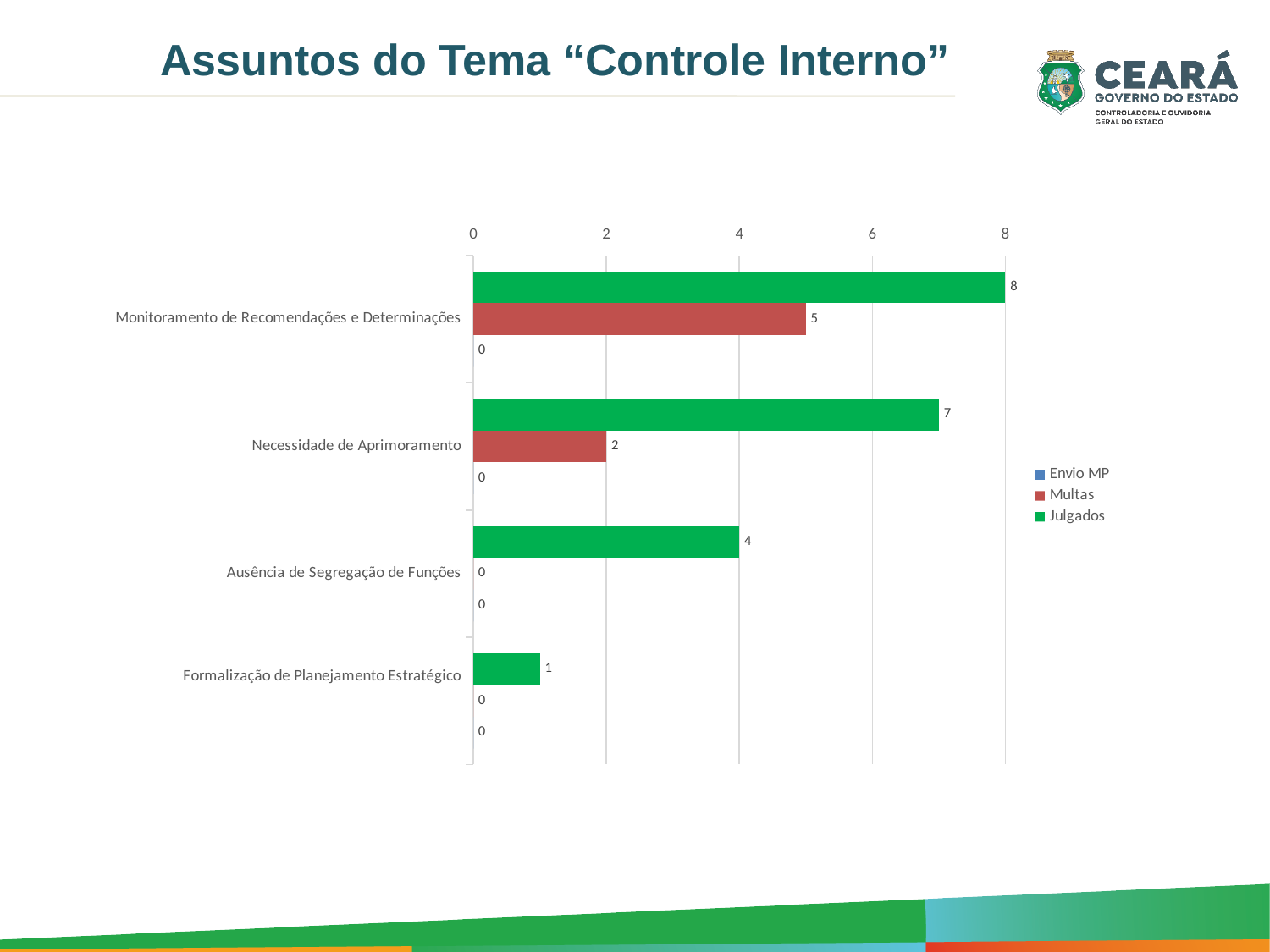
What colour are the Julgados bars? Green What is the Julgados value for Formalização de Planejamento Estratégico? 1 Which category has the highest Julgados value? Monitoramento de Recomendações e Determinações How many series does the legend list? 3 What is the difference between the Julgados and Multas values for Monitoramento de Recomendações e Determinações? 3 How many categories are shown on the chart? 4 Which category has the lowest Julgados value? Formalização de Planejamento Estratégico What is the Julgados value for Monitoramento de Recomendações e Determinações? 8 What is the Multas value for Necessidade de Aprimoramento? 2 What is the Envio MP value for Ausência de Segregação de Funções? 0 Which is larger: the Multas value for Monitoramento de Recomendações e Determinações or the Multas value for Necessidade de Aprimoramento? Monitoramento de Recomendações e Determinações What kind of chart is shown on the slide? Bar chart